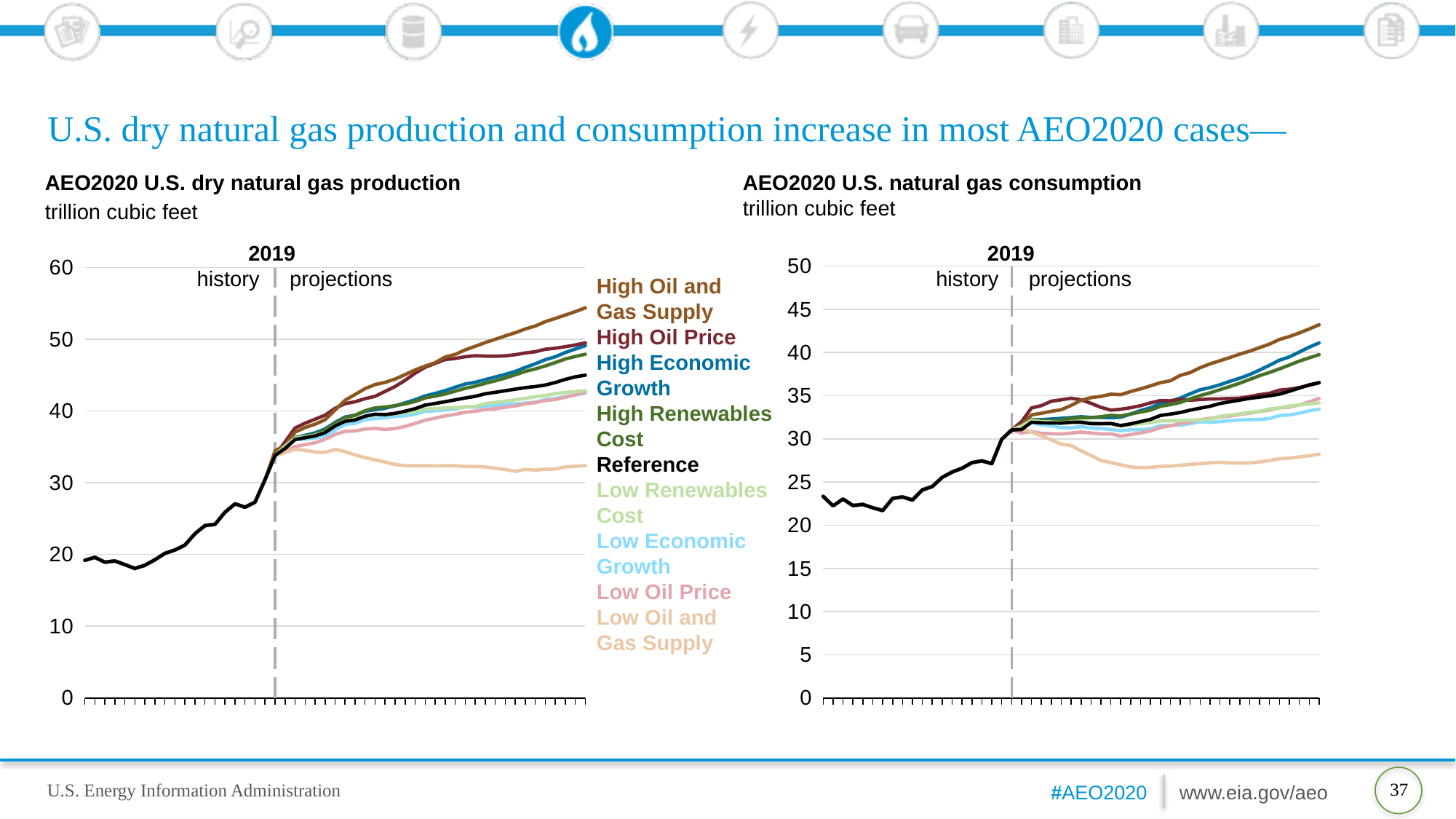
How many cases does the legend list for the charts on this slide? 9 In the AEO2020 U.S. dry natural gas production chart, is the High Oil and Gas Supply value at the end of the projections greater or less than 50? greater What year separates history from projections in both charts? 2019 In the AEO2020 U.S. natural gas consumption chart, which is larger at the end of the projections: the Reference case or the Low Oil and Gas Supply case? Reference In the AEO2020 U.S. dry natural gas production chart, which case has the lowest production at the end of the projection period? Low Oil and Gas Supply In the AEO2020 U.S. dry natural gas production chart, which case has the highest production at the end of the projection period? High Oil and Gas Supply In the AEO2020 U.S. dry natural gas production chart, does the Reference case rise or fall over the projection period? rise In the AEO2020 U.S. natural gas consumption chart, which case has the highest consumption at the end of the projection period? High Oil and Gas Supply In the AEO2020 U.S. natural gas consumption chart, is the High Oil and Gas Supply value at the end of the projections greater or less than 40? greater In the AEO2020 U.S. natural gas consumption chart, is the Low Oil and Gas Supply value at the end of the projections greater or less than 30? less What kind of chart is the AEO2020 U.S. dry natural gas production chart? line chart